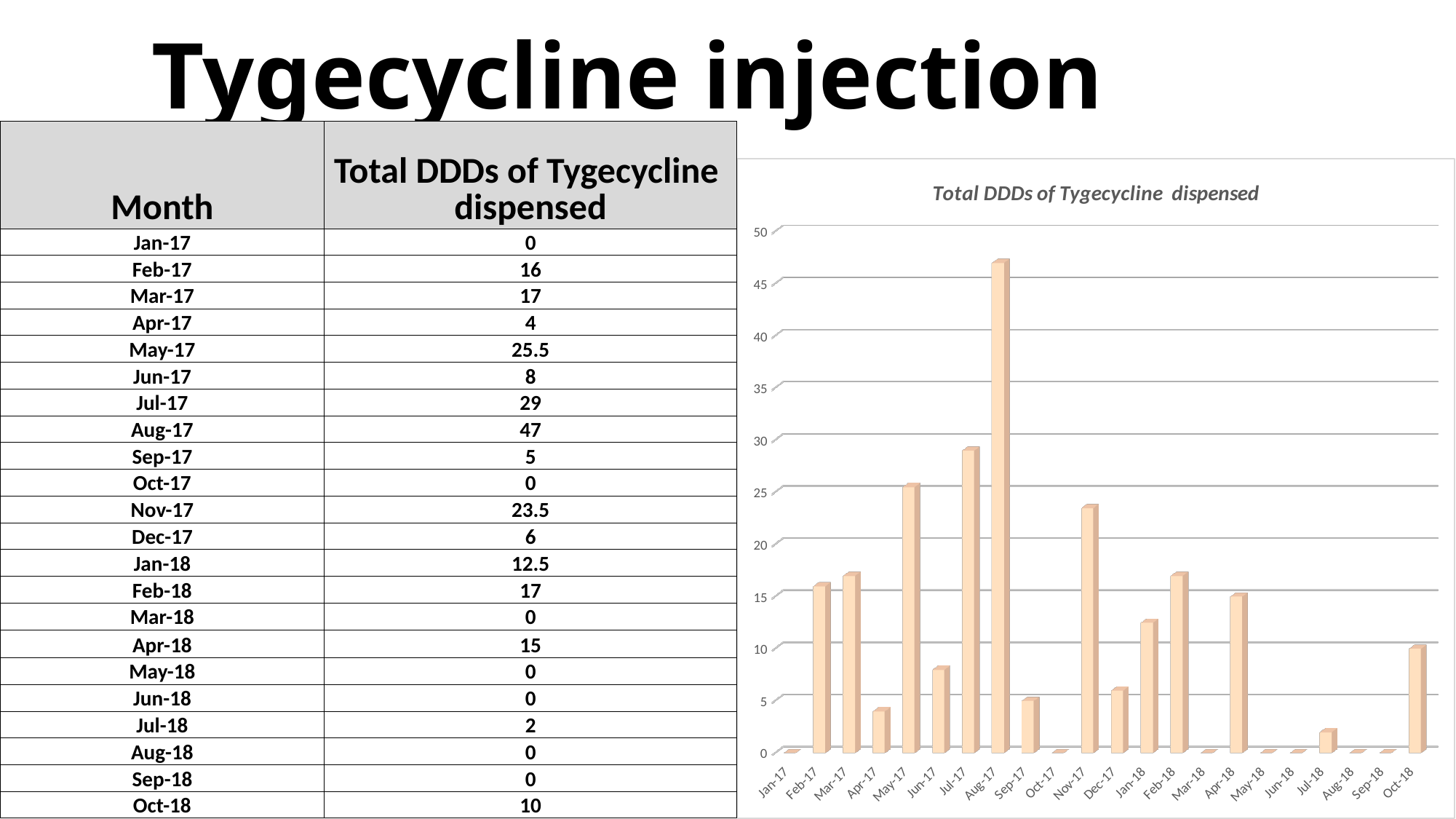
Is the value for Jul-17 greater or less than 25? greater What is the difference between the total DDDs dispensed in Aug-17 and Jul-17? 18 What type of chart is shown on the slide? bar chart Is the value for Apr-18 greater or less than 20? less Which is larger, the total DDDs dispensed in Nov-17 or in Feb-18? Nov-17 What is the difference between the total DDDs dispensed in Jan-18 and Dec-17? 6.5 What is the title of the chart? Total DDDs of Tygecycline dispensed What is the total DDDs of Tygecycline dispensed in May-17? 25.5 What is the total DDDs of Tygecycline dispensed in Aug-17? 47 What is the total DDDs of Tygecycline dispensed in Oct-18? 10 Which month has the highest total DDDs of Tygecycline dispensed? Aug-17 How many months are shown on the x axis of the chart? 22